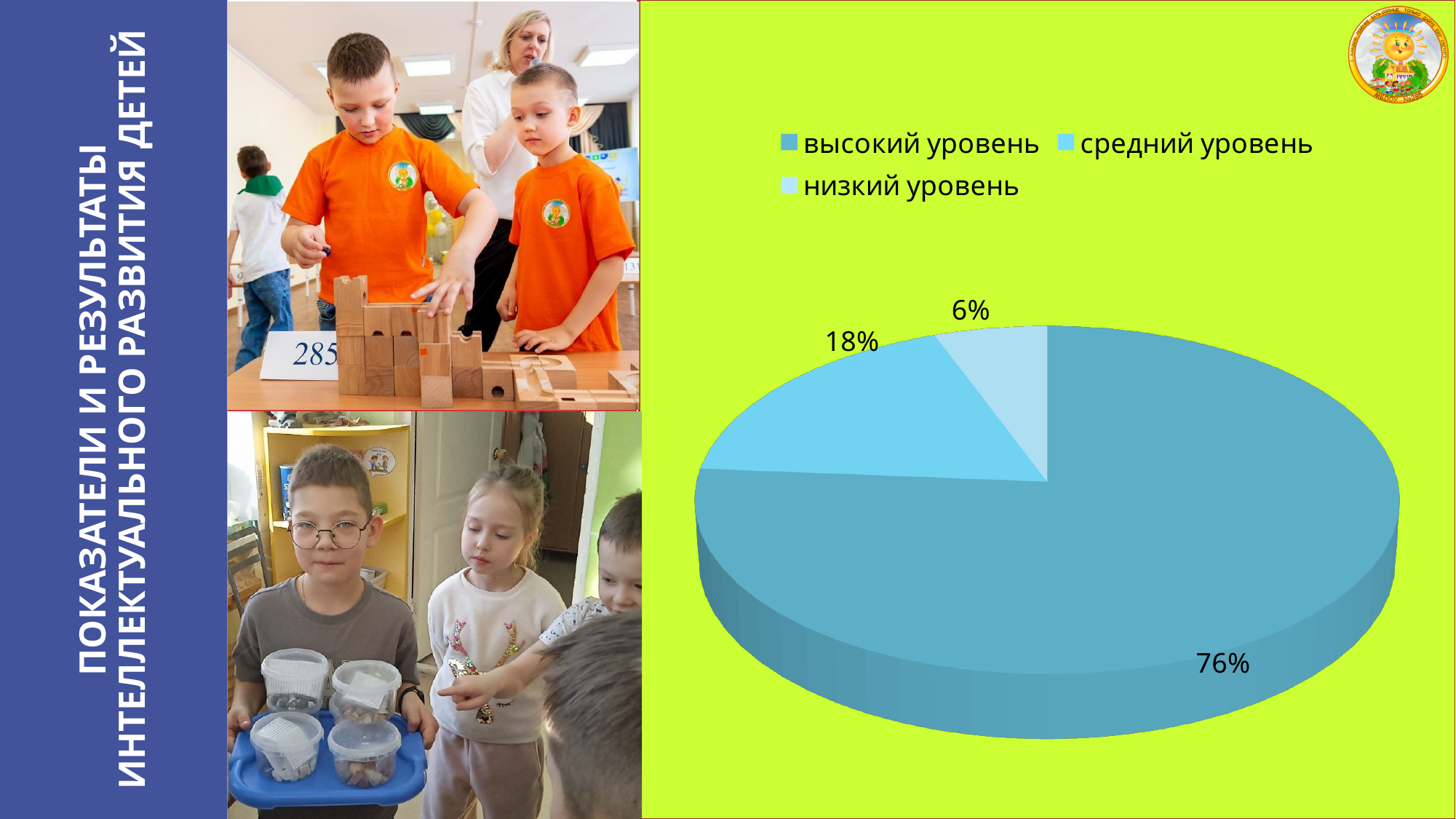
What is the difference between the shares of средний уровень and низкий уровень? 12% Which category has the largest share of the pie? высокий уровень What percentage is shown for высокий уровень? 76% What is the difference between the shares of высокий уровень and средний уровень? 58% What is the combined share of средний уровень and низкий уровень? 24% What kind of chart is shown on the slide? pie chart How many slices does the pie chart have? 3 Which is larger, the share for средний уровень or the share for низкий уровень? средний уровень How many entries does the legend list? 3 What percentage is shown for средний уровень? 18% Which category has the smallest share of the pie? низкий уровень What percentage is shown for низкий уровень? 6%